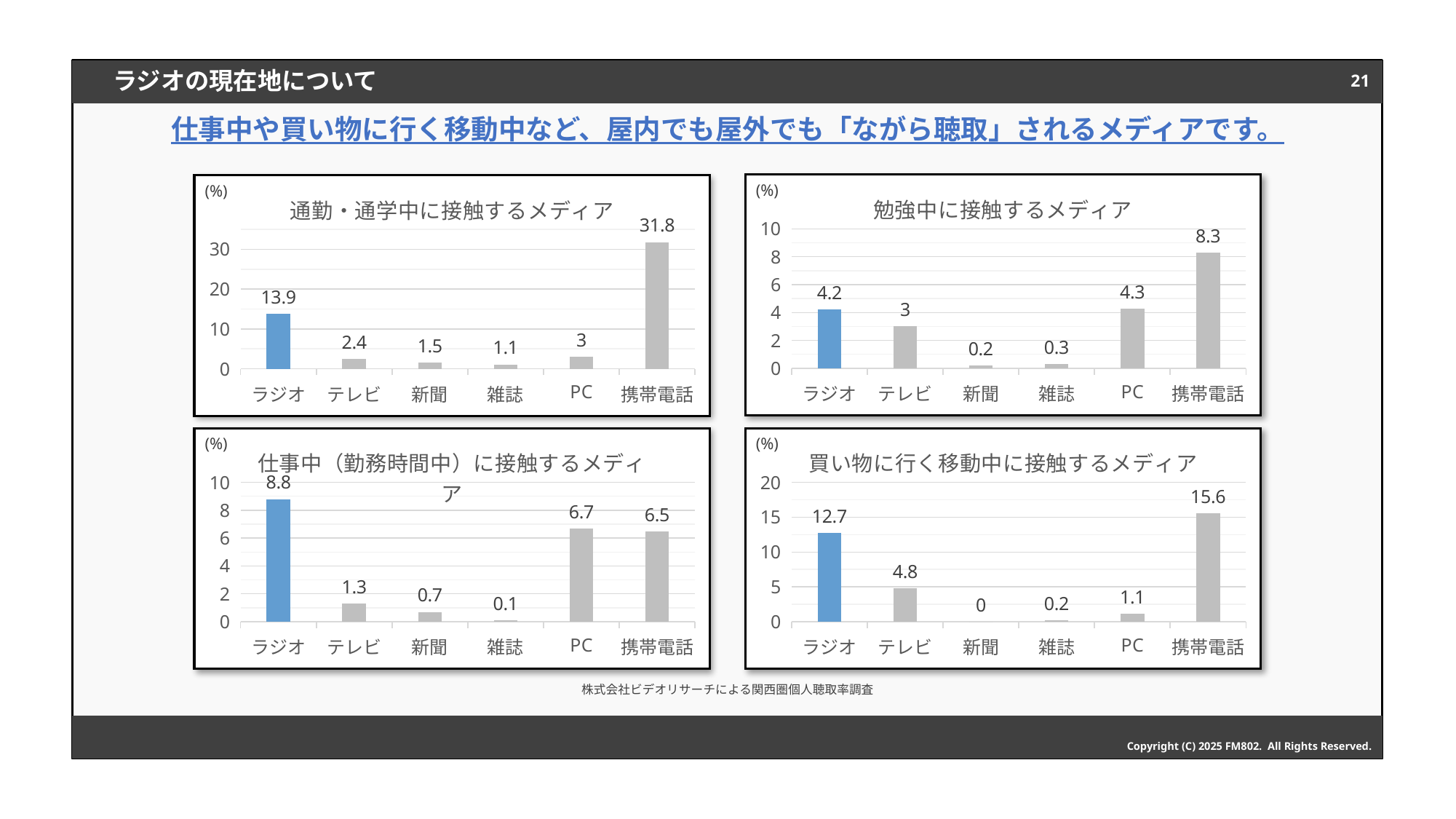
In the chart titled 仕事中（勤務時間中）に接触するメディア (bottom left), which is larger, the value for PC or the value for 携帯電話? PC In the chart titled 買い物に行く移動中に接触するメディア (bottom right), what is the difference between the values for 携帯電話 and ラジオ? 2.9 In the chart titled 仕事中（勤務時間中）に接触するメディア (bottom left), what is the value for 新聞? 0.7 What kind of chart is the chart titled 通勤・通学中に接触するメディア (top left)? Bar chart In the chart titled 勉強中に接触するメディア (top right), which category has the highest value? 携帯電話 In the chart titled 勉強中に接触するメディア (top right), what is the difference between the values for PC and テレビ? 1.3 In the chart titled 通勤・通学中に接触するメディア (top left), what is the value for 携帯電話? 31.8 In the chart titled 勉強中に接触するメディア (top right), what is the value for ラジオ? 4.2 In the chart titled 仕事中（勤務時間中）に接触するメディア (bottom left), which category has the highest value? ラジオ In the chart titled 買い物に行く移動中に接触するメディア (bottom right), what is the value for テレビ? 4.8 In the chart titled 通勤・通学中に接触するメディア (top left), which category has the lowest value? 雑誌 How many categories are shown on the x axis of the chart titled 買い物に行く移動中に接触するメディア (bottom right)? 6